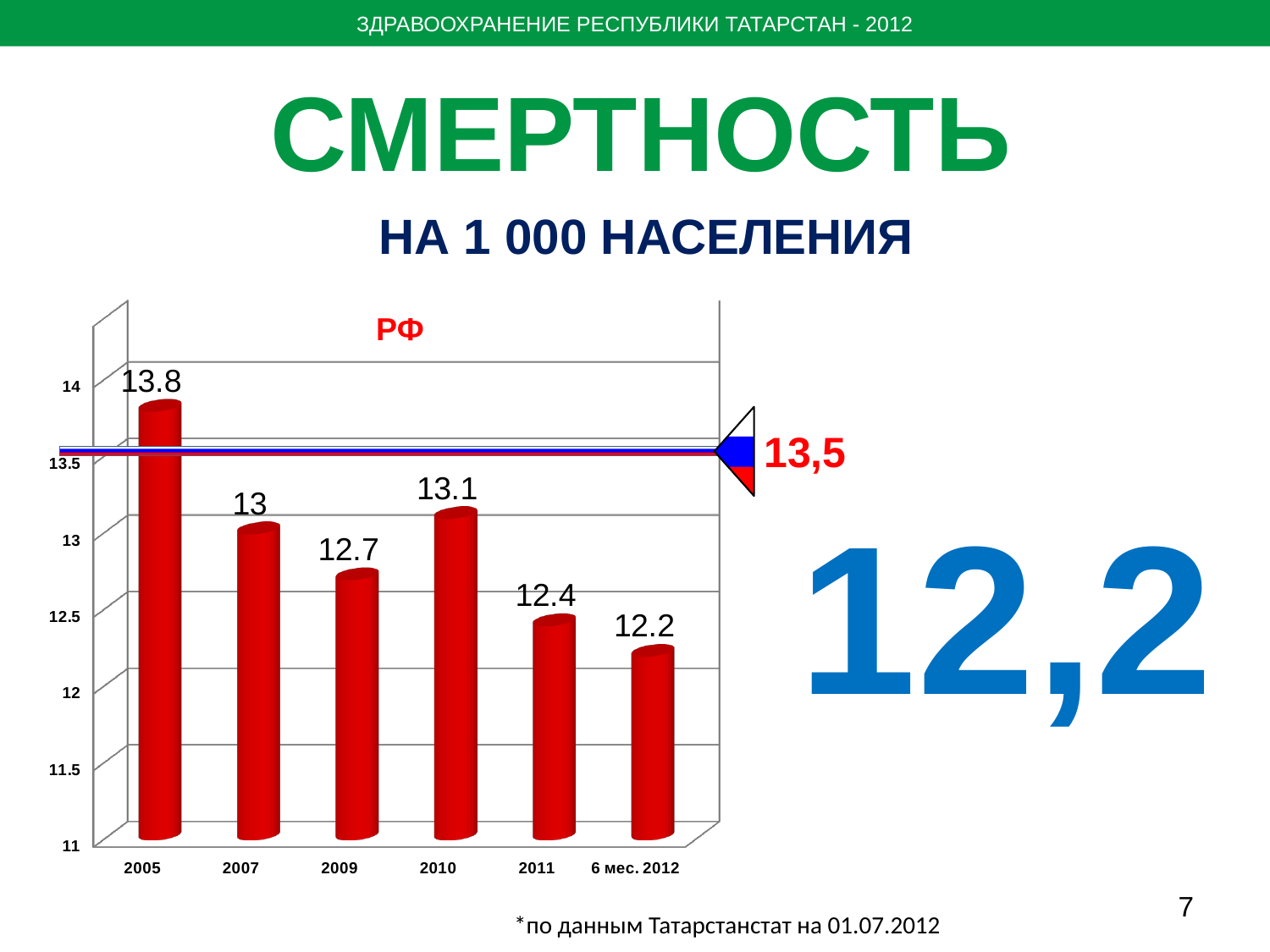
What kind of chart is shown on the slide? bar chart What is the mortality value for 6 мес. 2012? 12.2 Which year has the highest mortality value? 2005 What is the mortality value for 2005? 13.8 Which category has the lowest mortality value? 6 мес. 2012 What is the mortality value for 2009? 12.7 Is the value for 2011 greater or less than 12.5? less Do the values generally rise or fall from 2005 to 6 мес. 2012? fall What value is marked by the horizontal РФ reference line? 13,5 What is the difference between the values for 2005 and 2011? 1.4 Which is larger, the value for 2007 or the value for 2010? 2010 How many bars are shown in the chart? 6